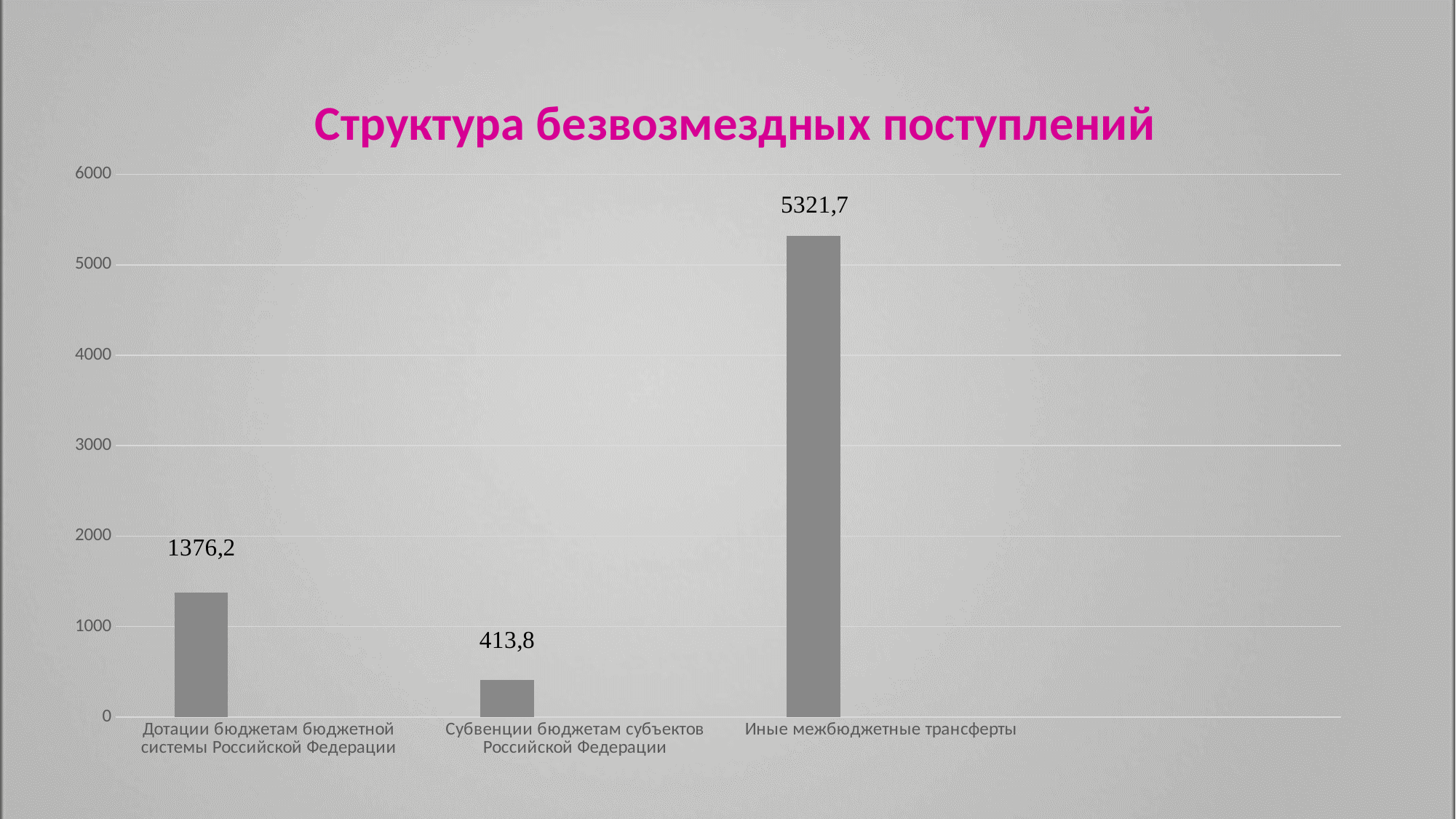
What is the difference between the values for Дотации бюджетам бюджетной системы Российской Федерации and Субвенции бюджетам субъектов Российской Федерации? 962,4 Is the value for Иные межбюджетные трансферты greater or less than 5000? greater What type of chart is shown on the slide? Bar chart What is the value for Субвенции бюджетам субъектов Российской Федерации? 413,8 How many categories are shown in the chart? 3 Which is larger: the value for Дотации бюджетам бюджетной системы Российской Федерации or the value for Субвенции бюджетам субъектов Российской Федерации? Дотации бюджетам бюджетной системы Российской Федерации What is the difference between the values for Иные межбюджетные трансферты and Дотации бюджетам бюджетной системы Российской Федерации? 3945,5 Which category has the highest value? Иные межбюджетные трансферты Is the value for Субвенции бюджетам субъектов Российской Федерации greater or less than 1000? less What is the value for Иные межбюджетные трансферты? 5321,7 What is the value for Дотации бюджетам бюджетной системы Российской Федерации? 1376,2 Which category has the lowest value? Субвенции бюджетам субъектов Российской Федерации